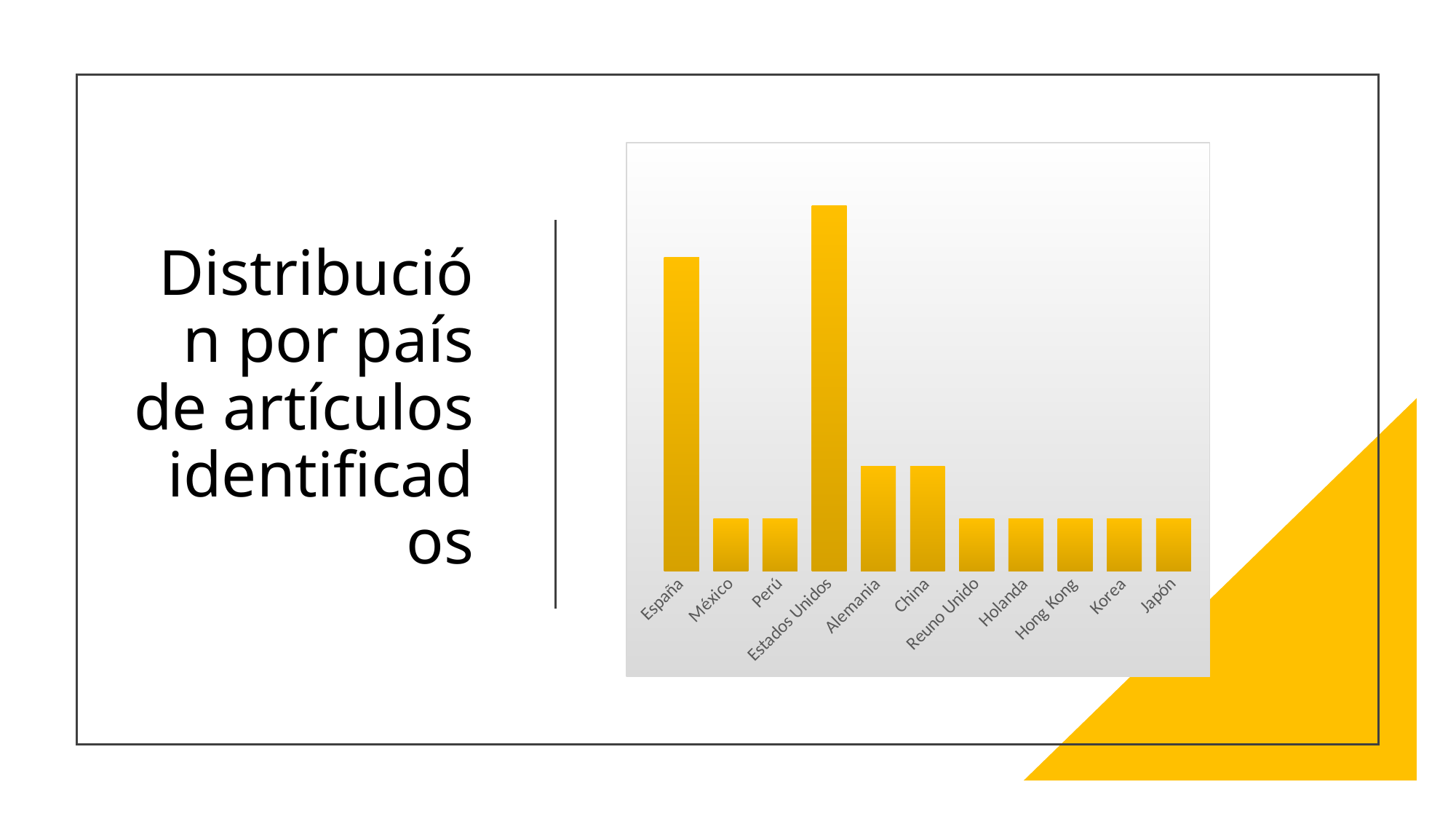
Which country has the highest bar in the chart? Estados Unidos What kind of chart is shown on the slide? Bar chart What colour are the bars in the chart? Yellow Which has the larger value, Alemania or México? Alemania How many countries are shown on the x axis of the chart? 11 Which country has the second-highest bar in the chart? España What is the first country listed on the x axis of the chart? España Which has the larger value, Perú or Estados Unidos? Estados Unidos Which has the larger value, España or Alemania? España